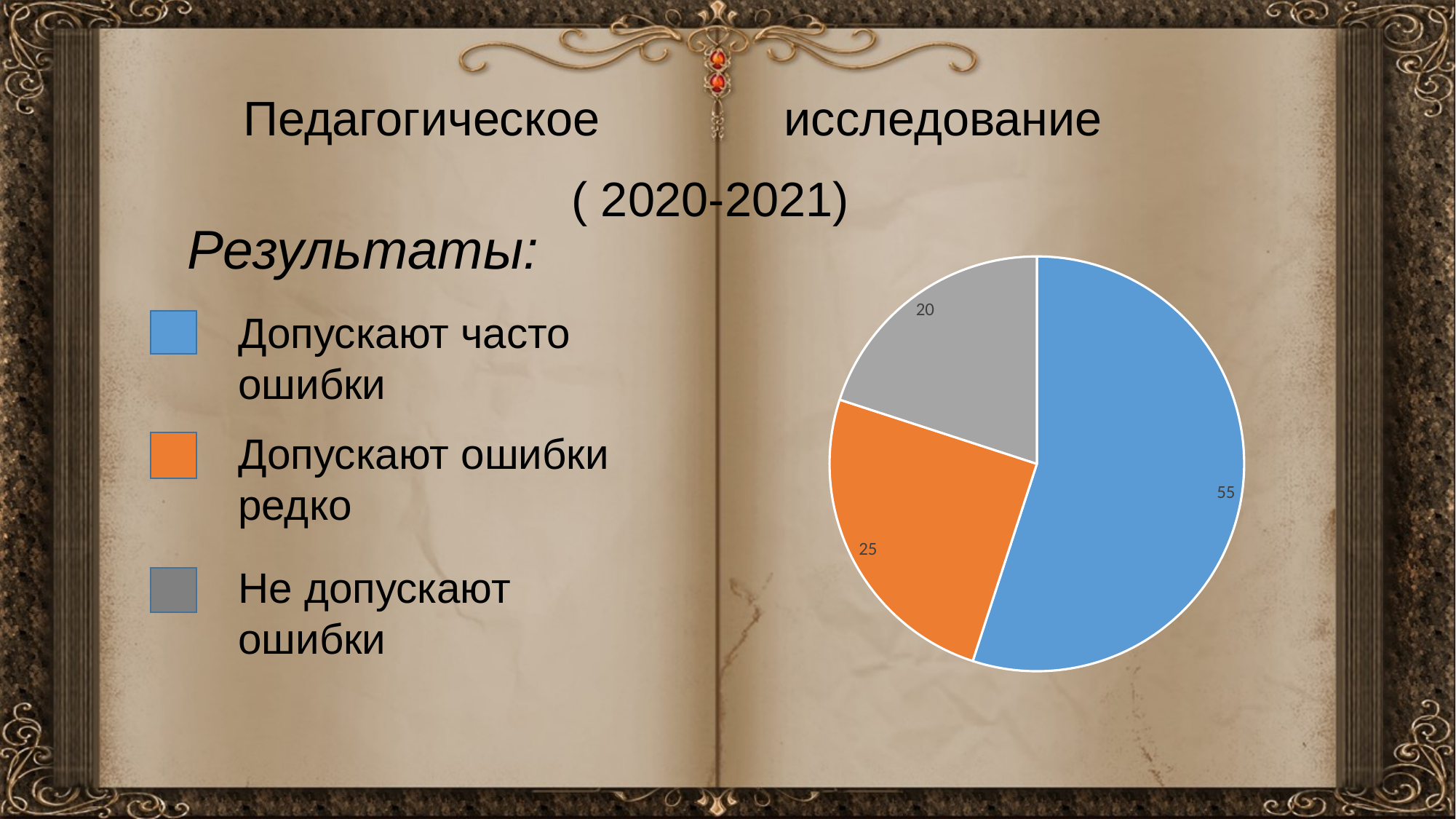
What is the difference between the values for "Допускают ошибки редко" and "Не допускают ошибки"? 5 What is the value for "Допускают часто ошибки" in the pie chart? 55 Which category has the largest slice in the pie chart? Допускают часто ошибки What kind of chart is shown on the slide? pie chart Which is larger: the value for "Допускают ошибки редко" or the value for "Не допускают ошибки"? Допускают ошибки редко Which category has the smallest slice in the pie chart? Не допускают ошибки What is the difference between the values for "Допускают часто ошибки" and "Допускают ошибки редко"? 30 What share of the pie does the "Допускают часто ошибки" slice represent? 55% How many slices does the pie chart have? 3 What colour is the slice for "Не допускают ошибки"? gray What is the value for "Допускают ошибки редко" in the pie chart? 25 What is the value for "Не допускают ошибки" in the pie chart? 20